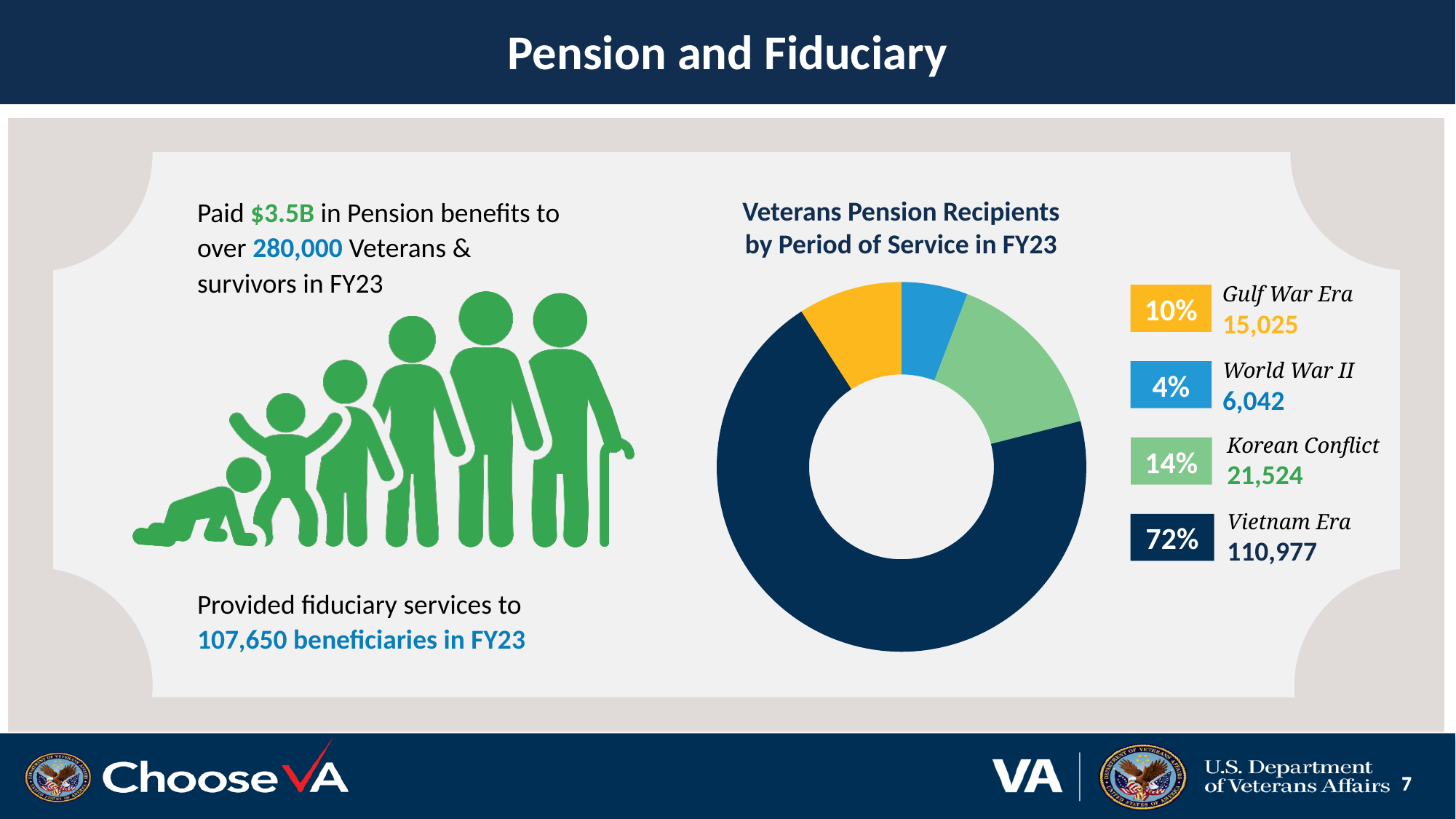
How many periods of service are shown in the chart? 4 How many Veterans pension recipients are from the Vietnam Era? 110,977 Which period of service has the smallest number of pension recipients? World War II What share of Veterans pension recipients are from the Gulf War Era? 10% Which period of service has the largest number of pension recipients? Vietnam Era What colour represents the Vietnam Era in the chart? Dark navy blue What kind of chart is shown on the slide? Doughnut chart What is the title of the chart? Veterans Pension Recipients by Period of Service in FY23 What is the difference in pension recipients between the Korean Conflict and the Gulf War Era? 6,499 How many Veterans pension recipients are from the Korean Conflict? 21,524 What share of Veterans pension recipients are from World War II? 4% Which has more pension recipients, the Gulf War Era or World War II? Gulf War Era